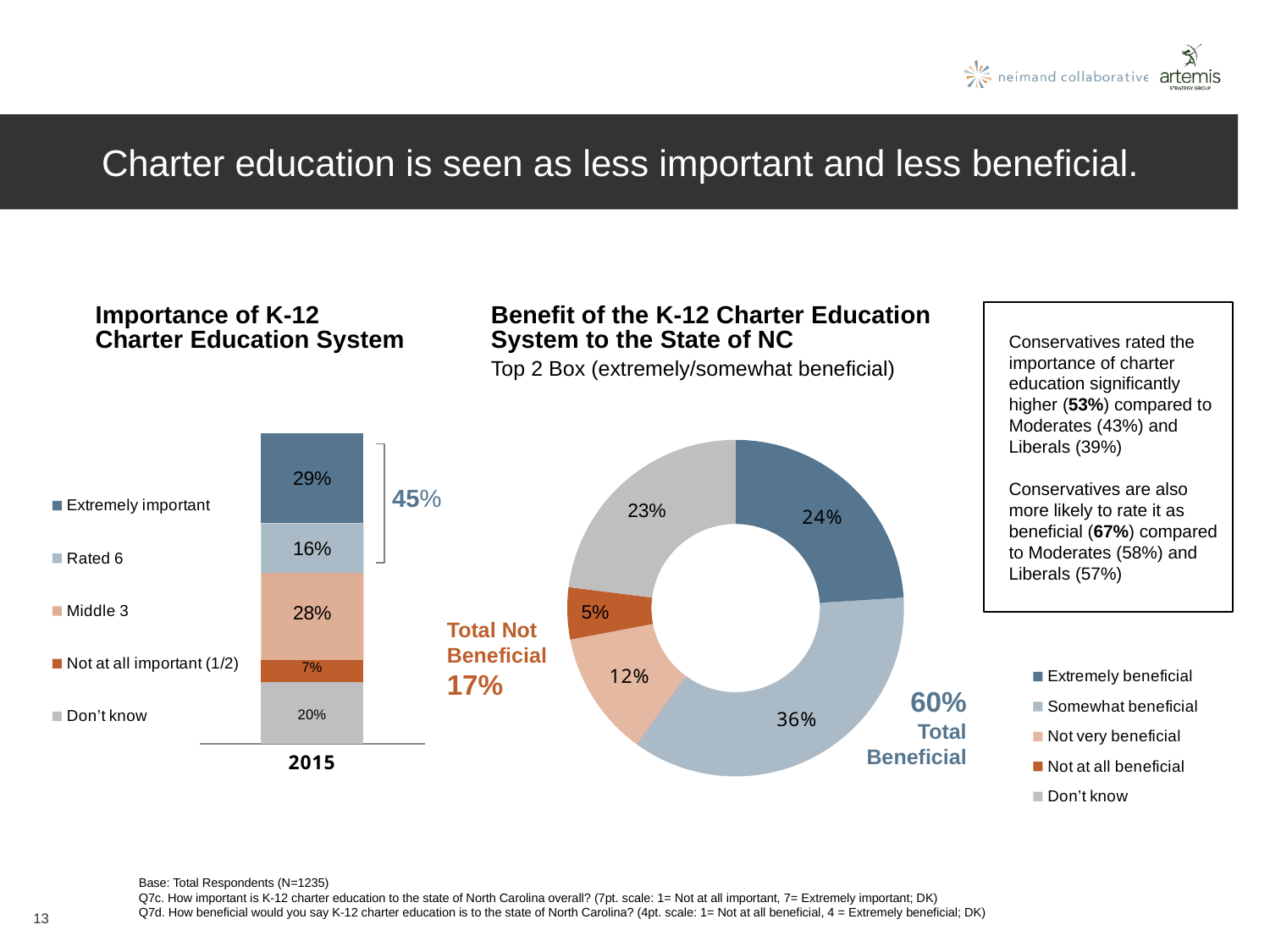
In the 'Benefit of the K-12 Charter Education System to the State of NC' chart, what percentage is shown for 'Somewhat beneficial'? 36% In the 'Importance of K-12 Charter Education System' chart, what percentage is shown for 'Middle 3'? 28% In the 'Importance of K-12 Charter Education System' chart, what is the difference between 'Extremely important' and 'Rated 6'? 13% What kind of chart is the 'Benefit of the K-12 Charter Education System to the State of NC' chart? Doughnut chart In the 'Importance of K-12 Charter Education System' chart, what percentage is shown for 'Don't know'? 20% In the 'Importance of K-12 Charter Education System' chart, which segment has the smallest value? Not at all important (1/2) In the 'Benefit of the K-12 Charter Education System to the State of NC' chart, which slice is the largest? Somewhat beneficial In the 'Importance of K-12 Charter Education System' chart, how many series does the legend list? 5 In the 'Benefit of the K-12 Charter Education System to the State of NC' chart, which is larger: 'Extremely beneficial' or 'Don't know'? Extremely beneficial In the 'Benefit of the K-12 Charter Education System to the State of NC' chart, what is the difference between 'Somewhat beneficial' and 'Not very beneficial'? 24% In the 'Benefit of the K-12 Charter Education System to the State of NC' chart, what percentage is shown for 'Not at all beneficial'? 5% In the 'Importance of K-12 Charter Education System' chart, what percentage is shown for 'Extremely important'? 29%